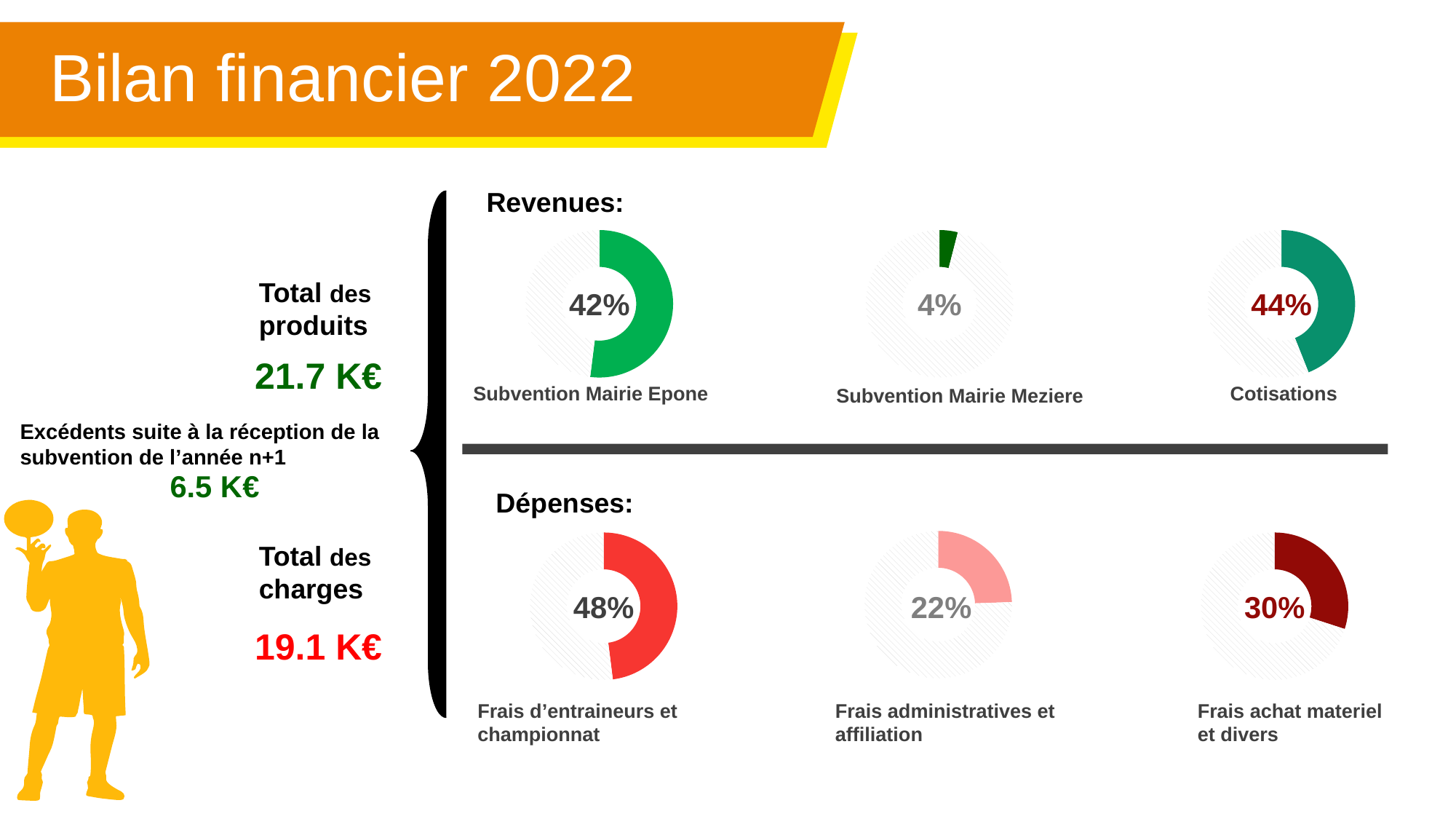
What percentage is shown on the Subvention Mairie Epone chart in the Revenues section? 42% What percentage is shown on the Cotisations chart? 44% In the Dépenses section, what percentage is shown for Frais d'entraineurs et championnat? 48% Among the three Revenues charts, which category has the lowest percentage? Subvention Mairie Meziere Among the three Dépenses charts, which category has the highest percentage? Frais d'entraineurs et championnat Among the three Revenues charts, which category has the highest percentage? Cotisations Which is larger: the percentage on the Subvention Mairie Epone chart or the percentage on the Cotisations chart? Cotisations What percentage is shown on the Subvention Mairie Meziere chart? 4% What is the difference in percentage points between the Frais d'entraineurs et championnat chart and the Frais administratives et affiliation chart? 26 What percentage is shown on the Frais administratives et affiliation chart? 22% How many donut charts are shown in the Dépenses section? 3 What percentage is shown on the Frais achat materiel et divers chart? 30%